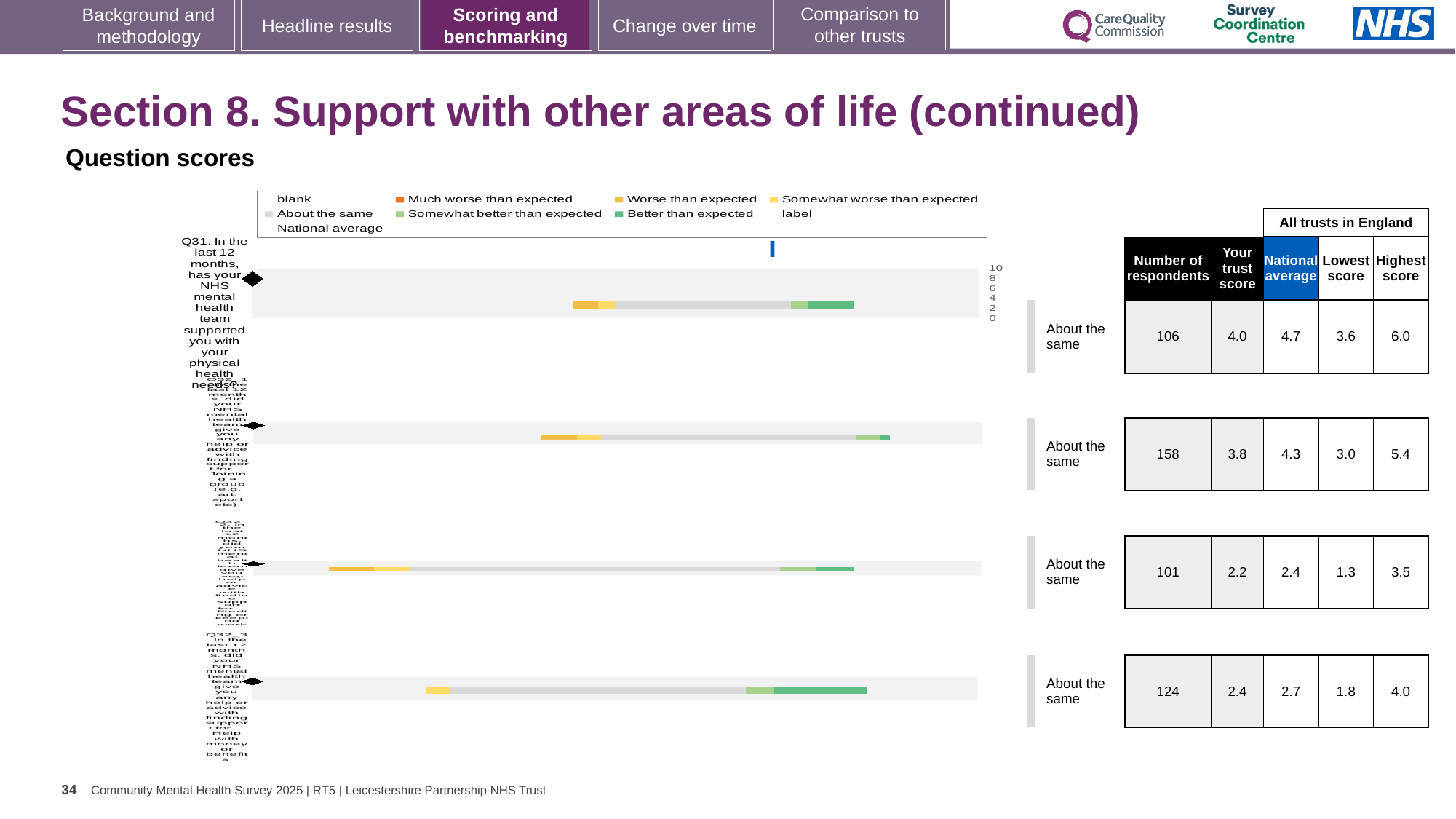
Which legend entry is shown in light grey? About the same In the table beside the chart, which bar has the highest number of respondents? the second bar (158) What kind of chart is shown on the slide? bar chart How many horizontal bars (questions) are plotted in the chart? 4 In the table beside the chart, what is the difference between the highest score and lowest score for the first bar (Q31)? 2.4 What benchmark label is shown to the right of the first bar (Q31)? About the same Which legend entry is shown in orange? Much worse than expected What is the highest tick value shown on the chart's axis? 10 In the table beside the chart, what is the trust score for the first bar (Q31)? 4.0 In the table beside the chart, what is the number of respondents for the first bar (Q31)? 106 In the table beside the chart, what is the national average for the second bar? 4.3 How many entries does the chart legend list? 9